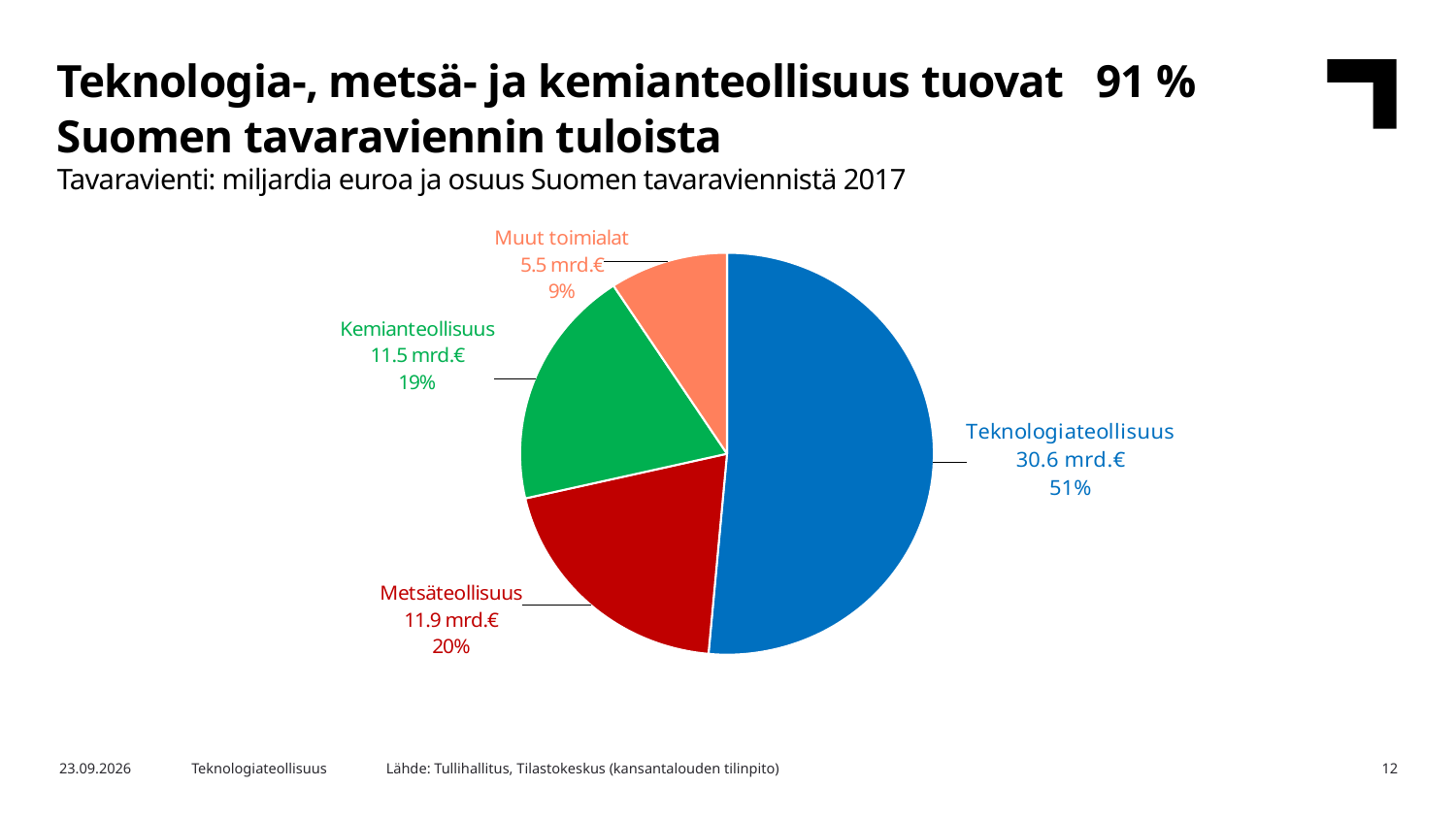
What share of the pie does Muut toimialat represent? 9% What type of chart is shown on the slide? Pie chart What share of the pie does Teknologiateollisuus represent? 51% What is the value for Kemianteollisuus in the pie chart? 11.5 mrd.€ What is the difference in value between Teknologiateollisuus and Metsäteollisuus? 18.7 mrd.€ Which category has the largest slice in the pie chart? Teknologiateollisuus Which colour is used for the Kemianteollisuus slice? Green Which category has the smallest slice in the pie chart? Muut toimialat What is the value for Muut toimialat in the pie chart? 5.5 mrd.€ What is the value for Teknologiateollisuus in the pie chart? 30.6 mrd.€ What is the value for Metsäteollisuus in the pie chart? 11.9 mrd.€ How many slices does the pie chart have? 4